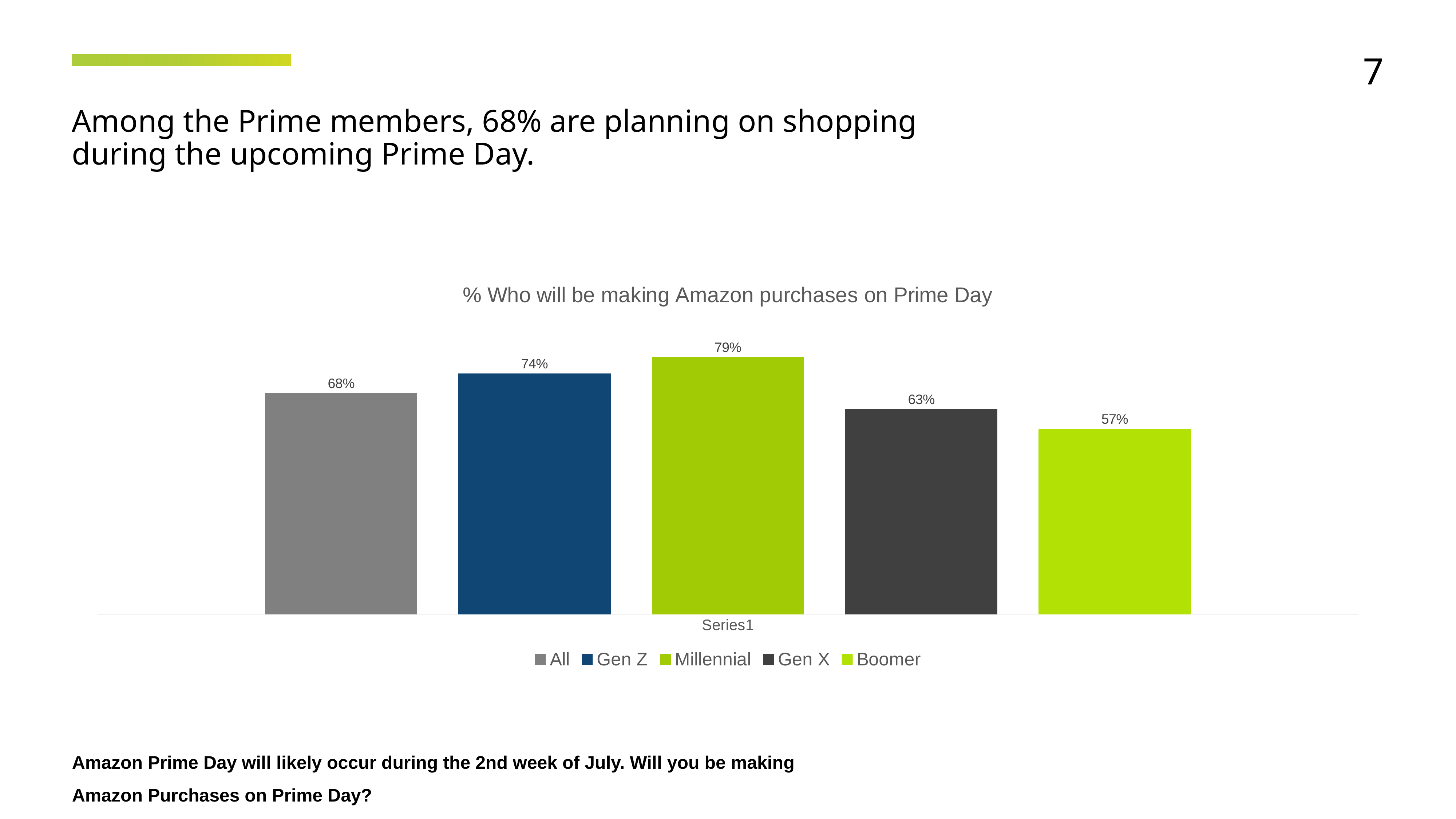
What is the difference between the Millennial and Boomer values? 22% What is the title of the chart? % Who will be making Amazon purchases on Prime Day What is the difference between the Gen Z and Gen X values? 11% What percentage of Millennials will be making Amazon purchases on Prime Day? 79% What is the value shown for Gen Z? 74% Which group has the lowest percentage who will be making Amazon purchases on Prime Day? Boomer What is the value shown for the All group? 68% What type of chart is shown on the slide? Bar chart What is the value shown for Boomer? 57% Which group has the highest percentage who will be making Amazon purchases on Prime Day? Millennial Which is larger, the value for Gen X or the value for All? All How many bars are shown in the chart? 5